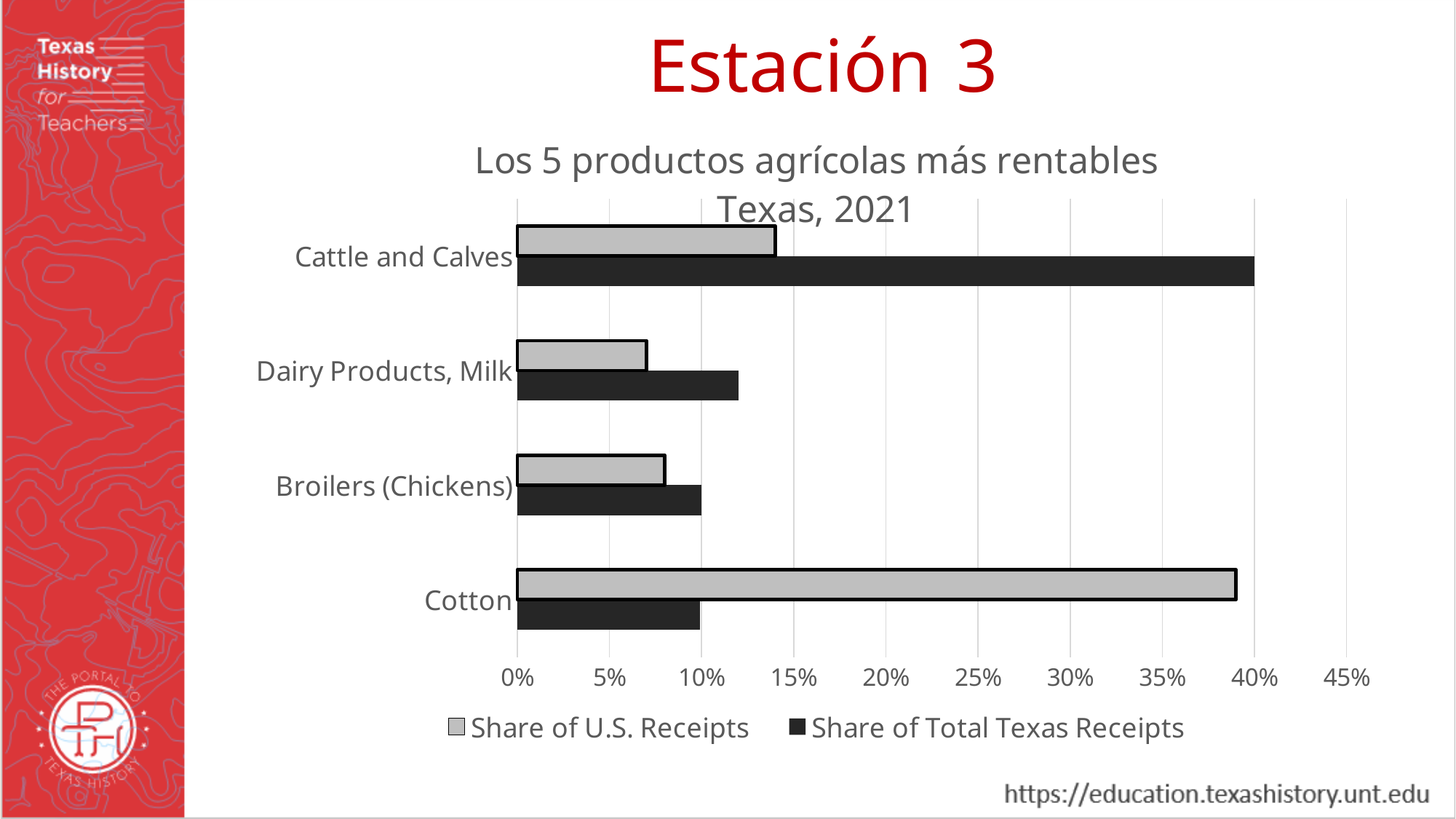
What kind of chart is shown on the slide? bar chart Which category has the highest Share of U.S. Receipts? Cotton For Cotton, which is larger: Share of U.S. Receipts or Share of Total Texas Receipts? Share of U.S. Receipts For Cattle and Calves, which is larger: Share of U.S. Receipts or Share of Total Texas Receipts? Share of Total Texas Receipts Which category has the highest Share of Total Texas Receipts? Cattle and Calves Is the Share of U.S. Receipts for Cotton greater or less than 35%? greater What is the Share of Total Texas Receipts for Cattle and Calves? 40% Is the Share of U.S. Receipts for Cattle and Calves greater or less than 10%? greater How many series does the legend list? 2 What is the title of the chart? Los 5 productos agrícolas más rentables Texas, 2021 Is the Share of U.S. Receipts for Dairy Products, Milk greater or less than 10%? less How many product categories are plotted on the chart? 4